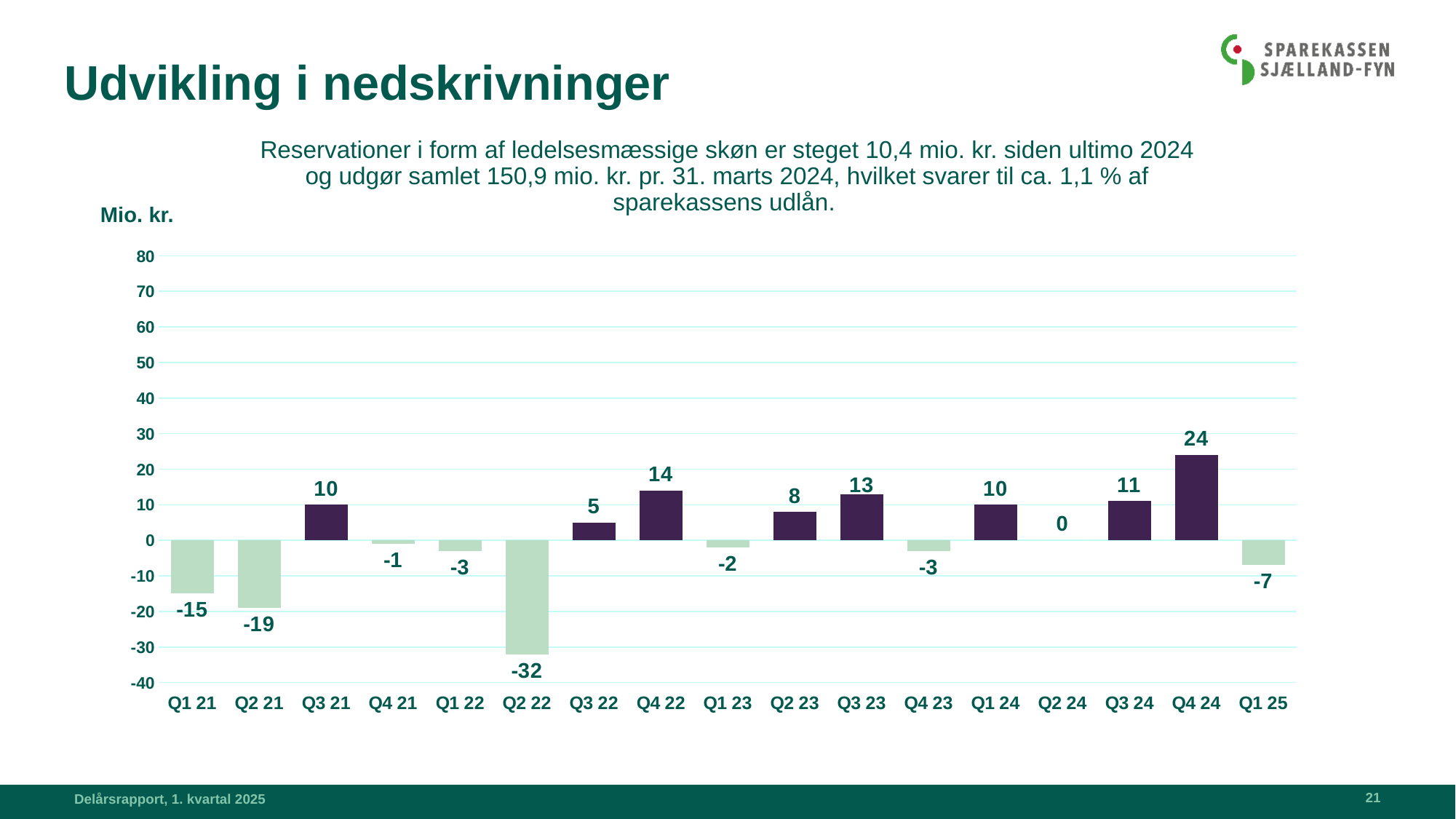
What kind of chart is shown on the slide? Bar chart Which is larger, the value for Q4 22 or the value for Q3 23? Q4 22 Which quarter has the highest value? Q4 24 What is the title of the slide? Udvikling i nedskrivninger What unit is shown on the y axis label? Mio. kr. What is the difference between the values for Q4 24 and Q3 24? 13 What is the value for Q2 24? 0 What is the value for Q2 22? -32 What is the value for Q4 24? 24 What is the value for Q1 25? -7 Which quarter has the lowest value? Q2 22 How many quarters are shown on the x axis? 17